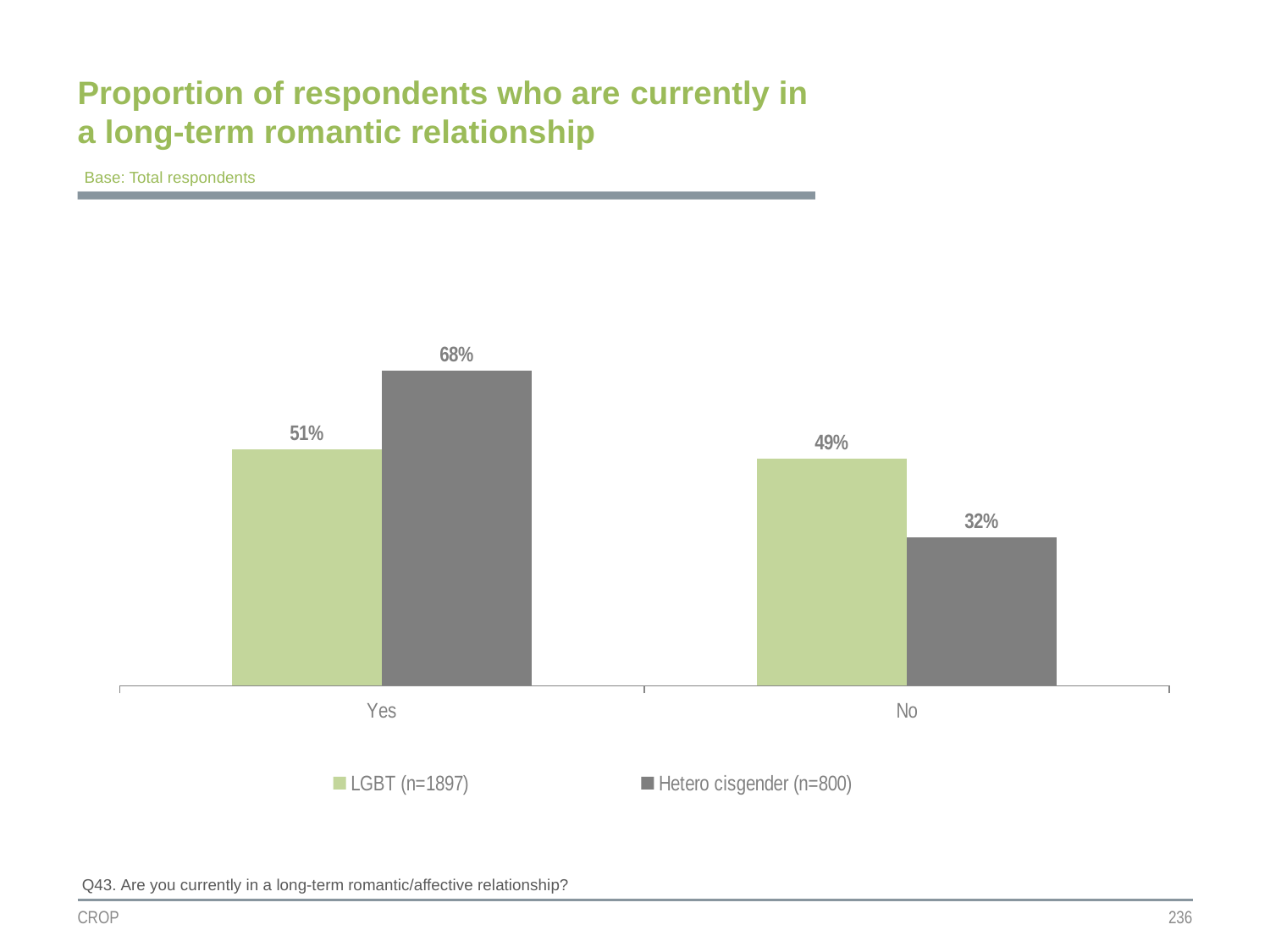
How many categories are shown on the x axis? 2 What percentage of Hetero cisgender respondents answered Yes? 68% How many series does the legend list? 2 What percentage of LGBT respondents answered No? 49% What percentage of LGBT respondents answered Yes? 51% Which group has the lower value for No? Hetero cisgender (n=800) Which group has the higher value for Yes? Hetero cisgender (n=800) What is the difference between the LGBT and Hetero cisgender values for No? 17 percentage points What is the sample size for the LGBT group shown in the legend? n=1897 What kind of chart is shown on the slide? Bar chart What is the difference between the Hetero cisgender and LGBT values for Yes? 17 percentage points What percentage of Hetero cisgender respondents answered No? 32%